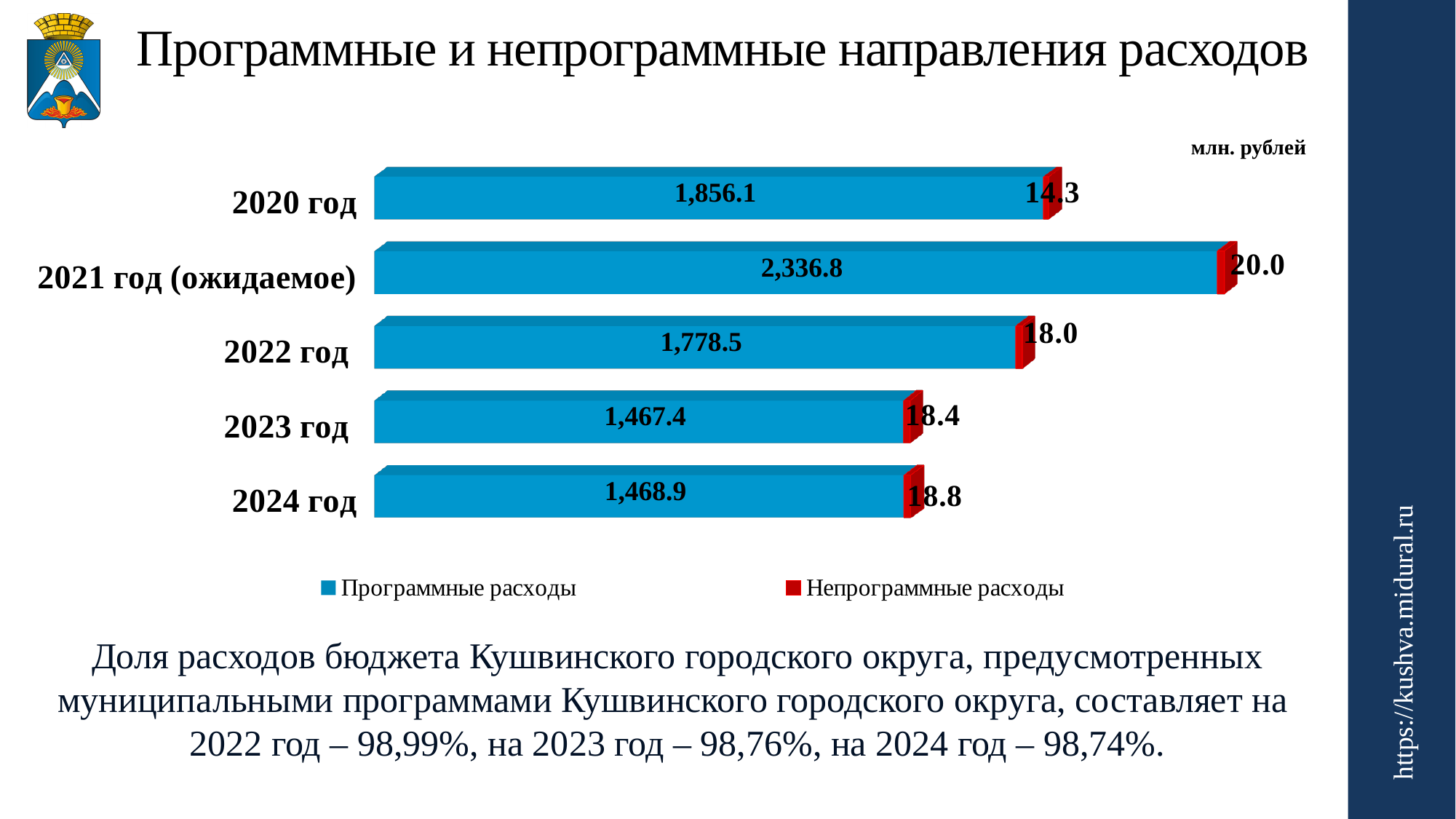
How many years (categories) are shown in the chart? 5 Which is larger: Непрограммные расходы in 2023 год or in 2024 год? 2024 год Which colour represents Непрограммные расходы in the chart? Red What is the difference between Программные расходы in 2021 год (ожидаемое) and in 2020 год? 480.7 How many series does the legend list? 2 Which year has the lowest value of Непрограммные расходы? 2020 год What is the value of Программные расходы for 2023 год? 1,467.4 What is the value of Непрограммные расходы for 2020 год? 14.3 What is the total of the stacked bar for 2022 год? 1,796.5 Which year has the highest value of Программные расходы? 2021 год (ожидаемое) What is the value of Программные расходы for 2021 год (ожидаемое)? 2,336.8 What kind of chart is shown on the slide? Stacked bar chart